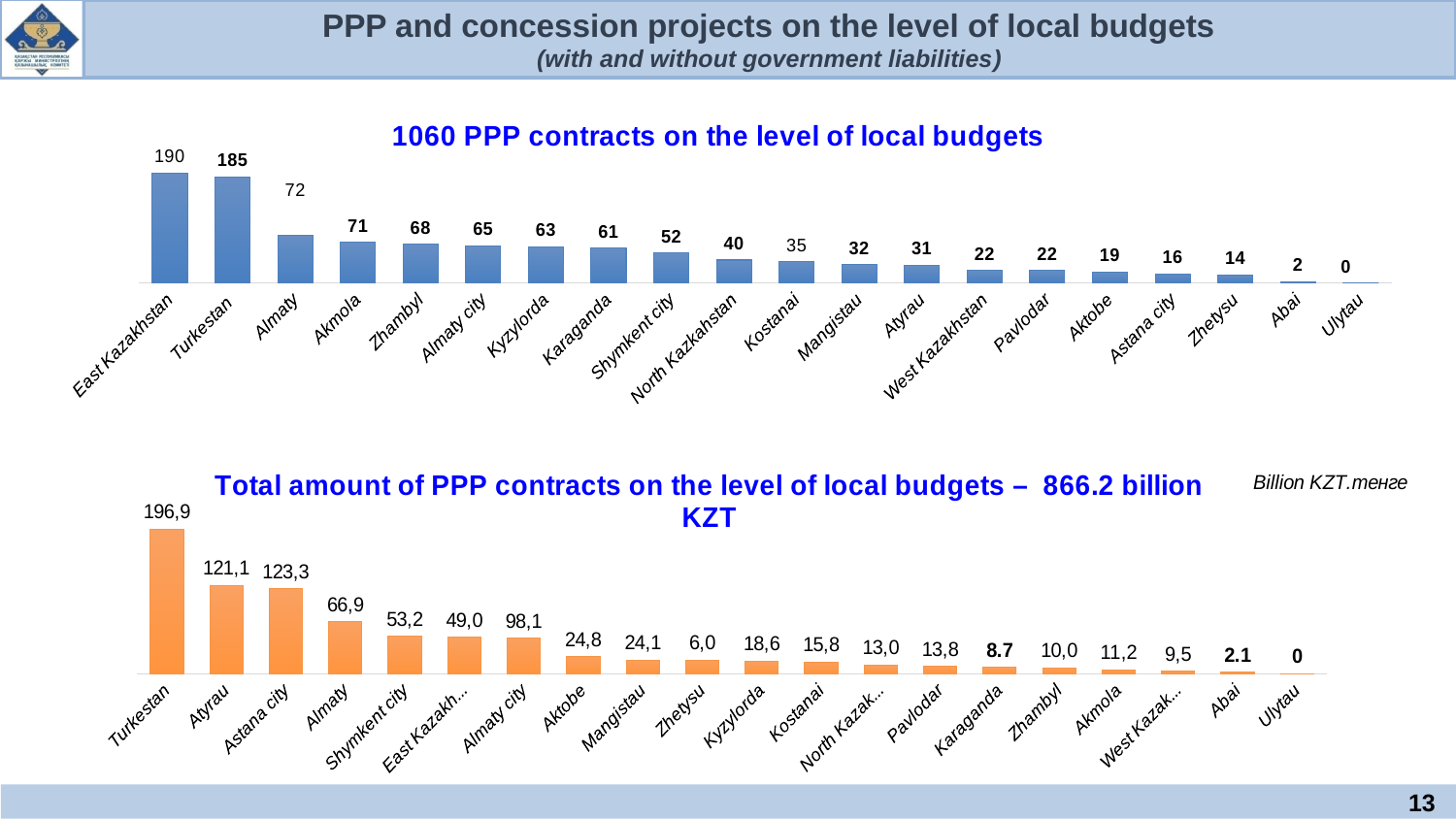
In the top chart (1060 PPP contracts on the level of local budgets), which region has the highest number of contracts? East Kazakhstan In the bottom chart (Total amount of PPP contracts on the level of local budgets), which is larger, the value for Atyrau or the value for Astana city? Astana city In the top chart (1060 PPP contracts on the level of local budgets), how many regions are shown on the x axis? 20 In the bottom chart (Total amount of PPP contracts on the level of local budgets), what is the value for Almaty city? 98,1 In the top chart (1060 PPP contracts on the level of local budgets), what is the value for Shymkent city? 52 In the bottom chart (Total amount of PPP contracts on the level of local budgets), what is the difference between the values for Aktobe and Mangistau? 0,7 In the top chart (1060 PPP contracts on the level of local budgets), what is the difference between the values for Turkestan and Almaty? 113 In the bottom chart (Total amount of PPP contracts on the level of local budgets), what is the value for Turkestan? 196,9 What type of chart is the bottom chart (Total amount of PPP contracts on the level of local budgets)? Bar chart In the top chart (1060 PPP contracts on the level of local budgets), how many PPP contracts does East Kazakhstan have? 190 In the top chart (1060 PPP contracts on the level of local budgets), which region has the lowest number of contracts? Ulytau In the bottom chart (Total amount of PPP contracts on the level of local budgets), which region has the highest value? Turkestan